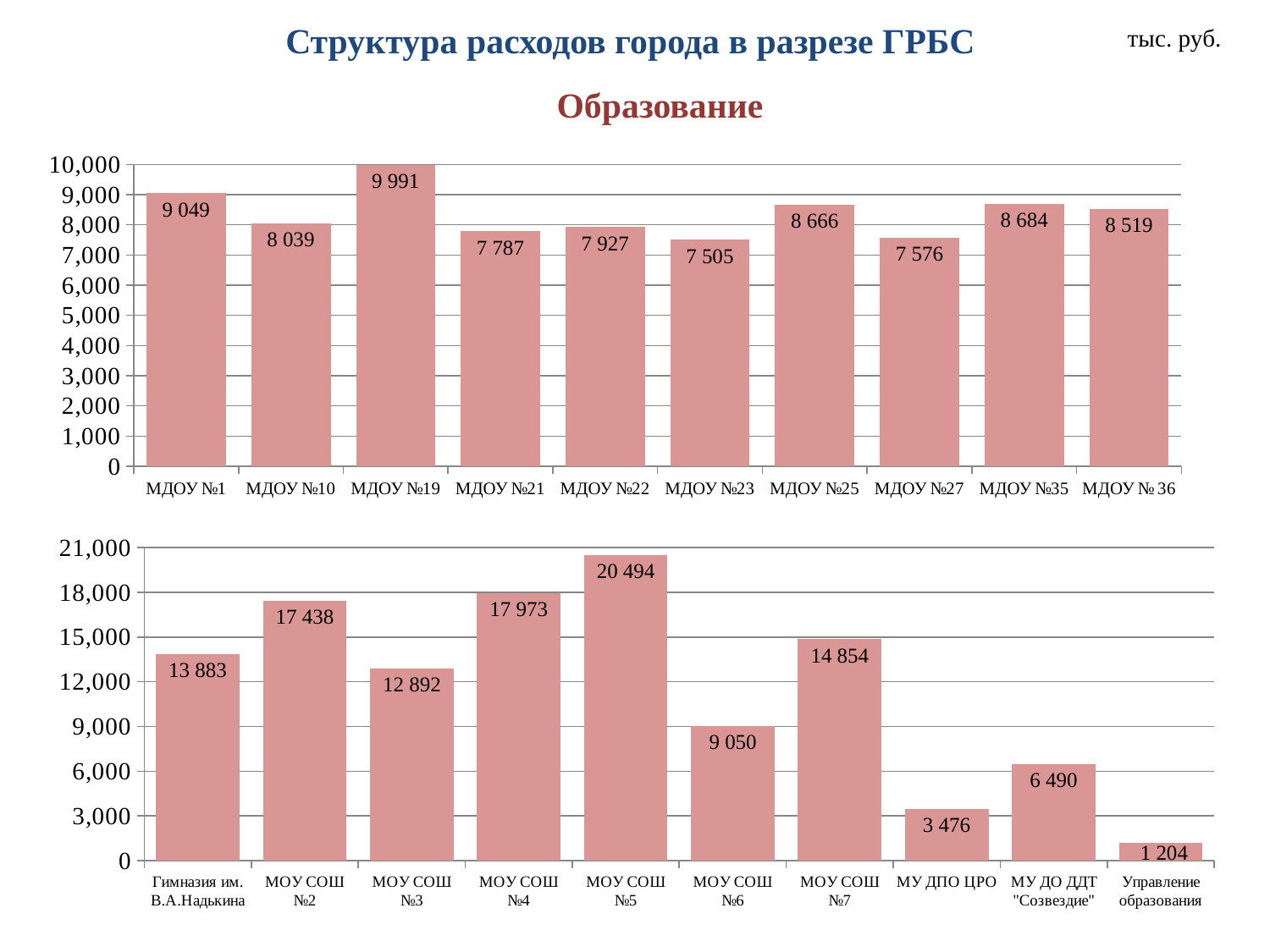
In the bottom chart, is the value for МУ ДО ДДТ "Созвездие" greater or less than 6,000? greater In the top chart, what is the value for МДОУ №19? 9 991 In the bottom chart, what is the value for МОУ СОШ №6? 9 050 What is the subtitle shown above the charts, below the main title? Образование What kind of chart is the bottom chart? bar chart In the top chart, which category has the lowest value? МДОУ №23 In the top chart, what is the difference between the values for МДОУ №1 and МДОУ №10? 1 010 In the bottom chart, what is the difference between the values for МОУ СОШ №4 and МОУ СОШ №2? 535 How many categories are shown in the top chart? 10 In the bottom chart, which category has the highest value? МОУ СОШ №5 In the top chart, which is larger: the value for МДОУ №25 or the value for МДОУ №35? МДОУ №35 In the bottom chart, which category has the lowest value? Управление образования